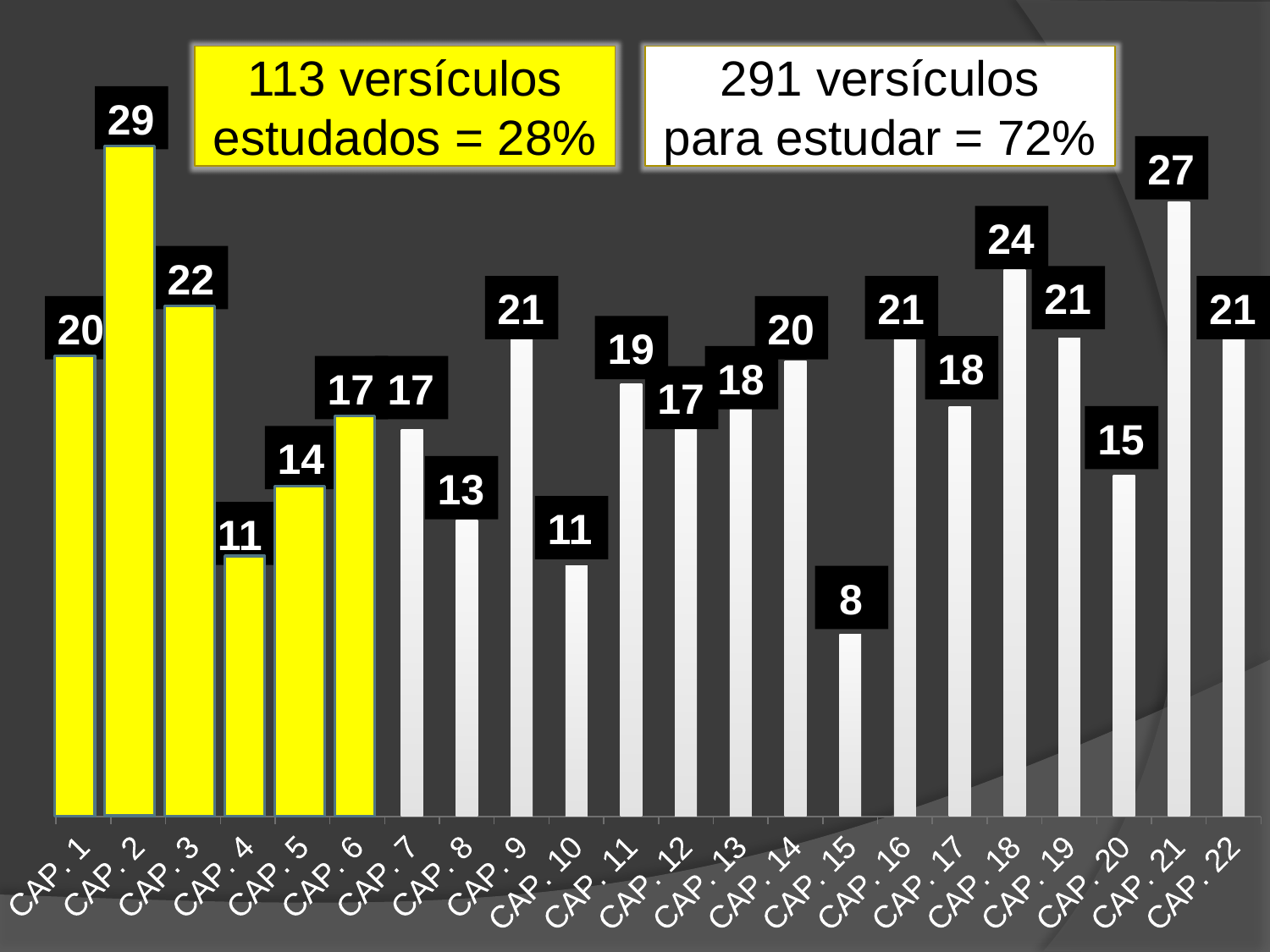
What is the difference between the values for CAP. 21 and CAP. 20? 12 What is the value for CAP. 2? 29 What is the value for CAP. 18? 24 What is the value for CAP. 15? 8 What is the difference between the values for CAP. 2 and CAP. 15? 21 According to the yellow text box, how many verses have been studied and what percentage is that? 113 versículos = 28% Which is larger, the value for CAP. 3 or the value for CAP. 11? CAP. 3 How many categories (chapters) are plotted on the chart? 22 Which chapter has the lowest value? CAP. 15 How many bars are coloured yellow on the chart? 6 Which chapter has the highest value? CAP. 2 What type of chart is shown on the slide? bar chart